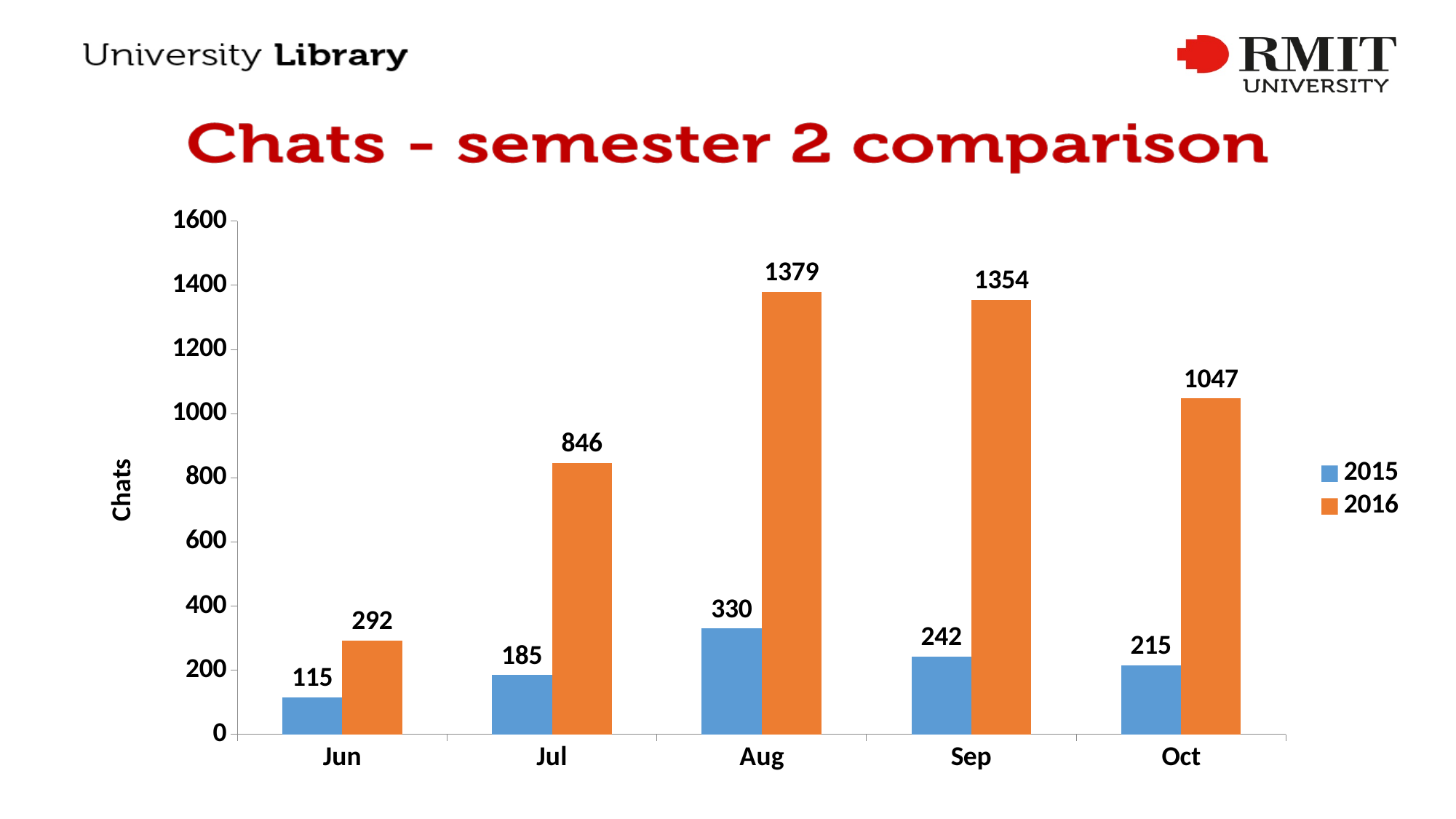
What kind of chart is shown on the slide? bar chart What is the title of the chart? Chats - semester 2 comparison Is the value for 2016 in Oct greater or less than 1000? greater How many months are shown on the x axis? 5 How many series does the legend list? 2 What is the difference between the 2016 and 2015 values in Jul? 661 Which is larger, the 2016 value for Sep or the 2016 value for Oct? Sep Which month has the lowest number of chats for 2015? Jun Which month has the highest number of chats for 2016? Aug What is the value for 2015 in Sep? 242 How many chats were there in Aug 2016? 1379 What is the label on the vertical axis? Chats